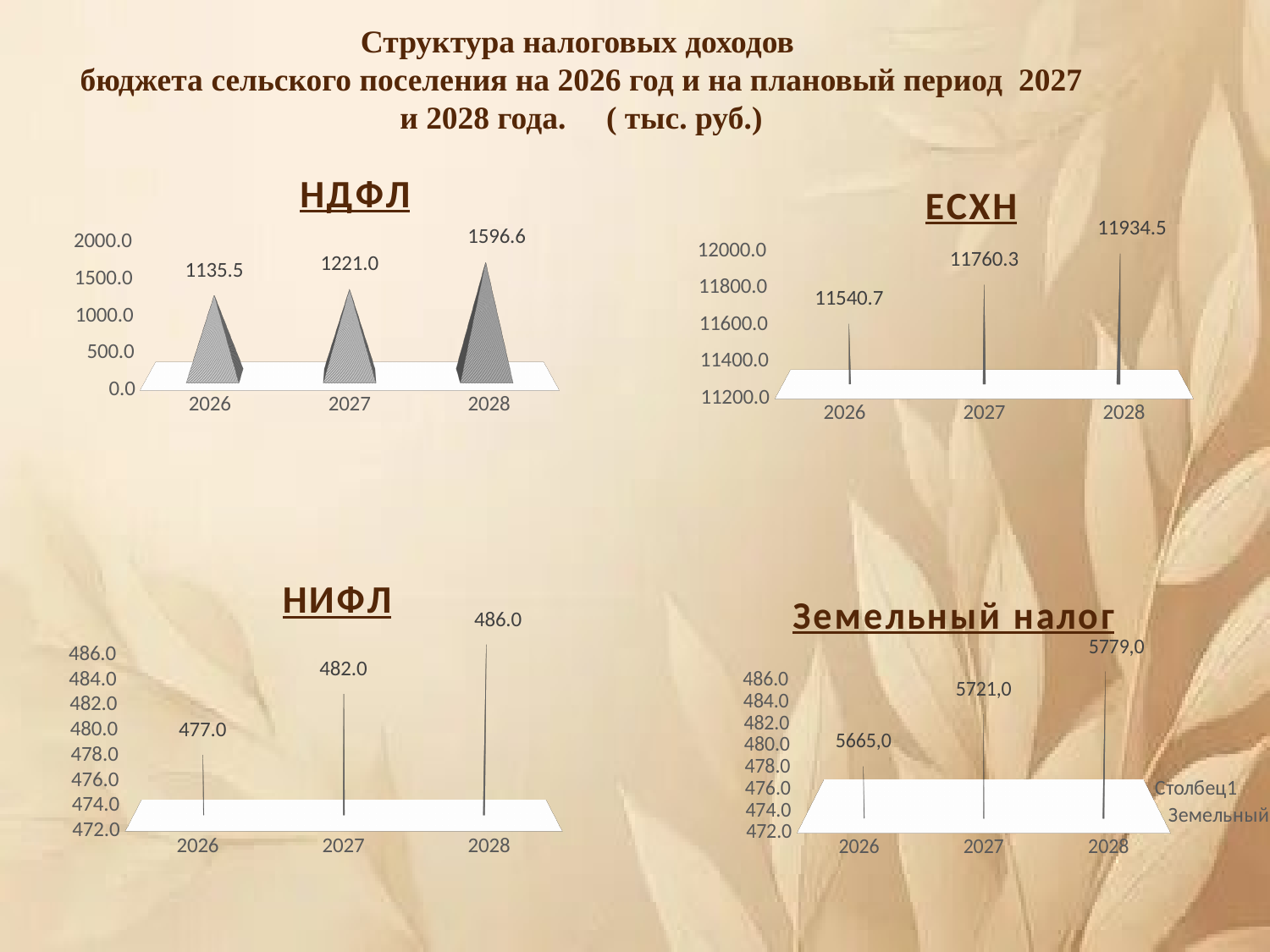
In the ЕСХН chart, which year has the lowest value? 2026 What kind of chart is the НДФЛ chart? bar chart In the НИФЛ chart, do the values rise or fall from 2026 to 2028? rise In the Земельный налог chart, which is larger, the value for 2026 or 2028? 2028 In the НИФЛ chart, what is the value for 2028? 486.0 In the НДФЛ chart, what is the difference between the 2028 and 2026 values? 461.1 In the Земельный налог chart, what is the value for 2027? 5721,0 In the НДФЛ chart, what is the value for 2027? 1221.0 How many years are shown on the x axis of the ЕСХН chart? 3 In the НДФЛ chart, which year has the highest value? 2028 In the ЕСХН chart, what is the value for 2026? 11540.7 In the ЕСХН chart, what is the difference between the 2028 and 2027 values? 174.2